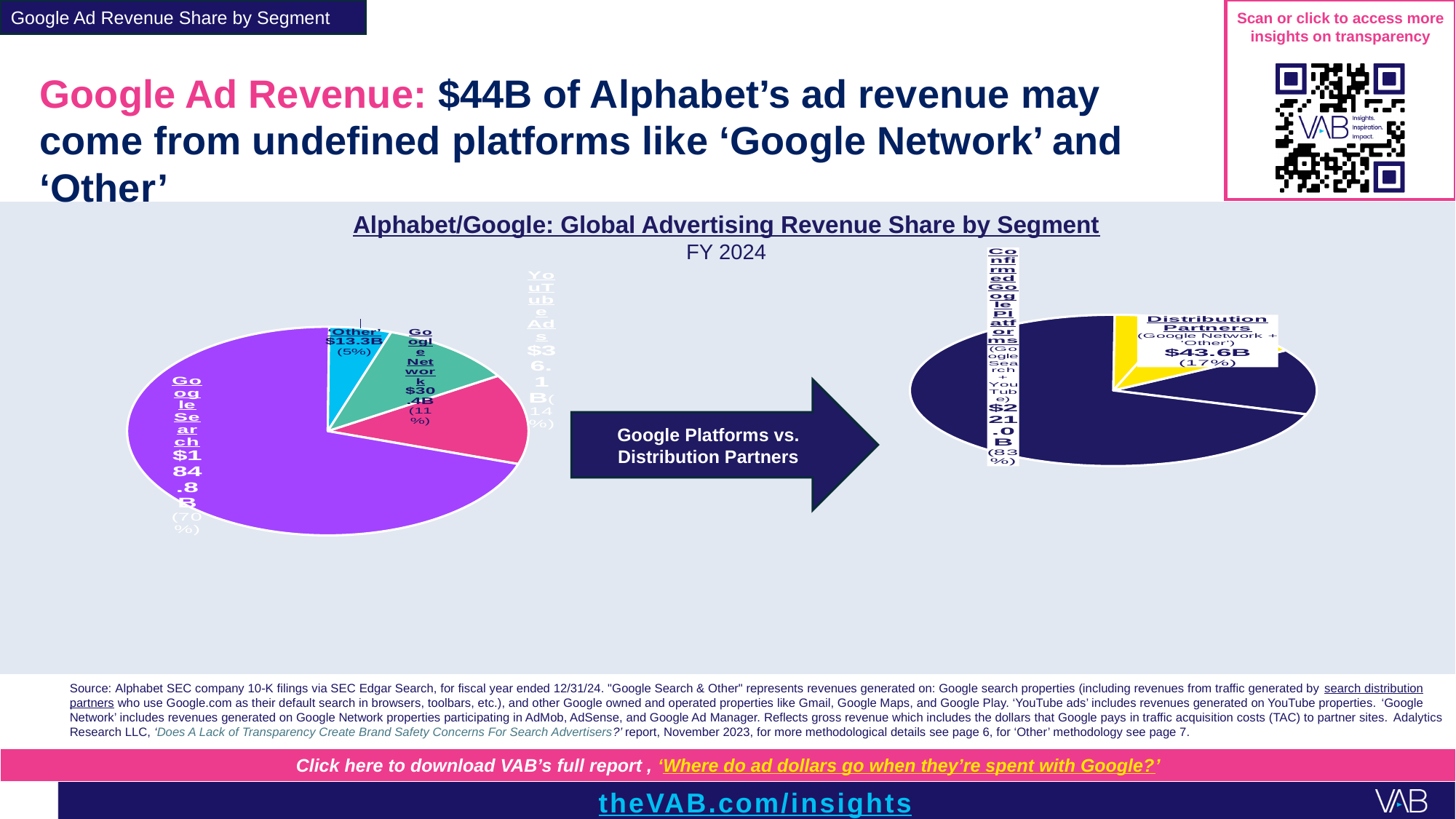
In the left pie chart, which segment has the largest share? Google Search In the right pie chart, what is the revenue value shown for Distribution Partners? $43.6B In the left pie chart, what percentage share is shown for 'Other'? 5% What type of chart is used on the left side of the slide to show Alphabet/Google's advertising revenue share by segment? Pie chart In the left pie chart, what is the revenue value shown for Google Search? $184.8B In the left pie chart, which segment has the smallest share? 'Other' In the left pie chart, which is larger: YouTube Ads or Google Network? YouTube Ads In the left pie chart, what percentage share is shown for YouTube Ads? 14% What fiscal year is shown under the chart title? FY 2024 In the left pie chart, what is the revenue value shown for Google Network? $30.4B How many segments are shown in the left pie chart? 4 In the right pie chart, what percentage share is shown for Confirmed Google Platforms? 83%